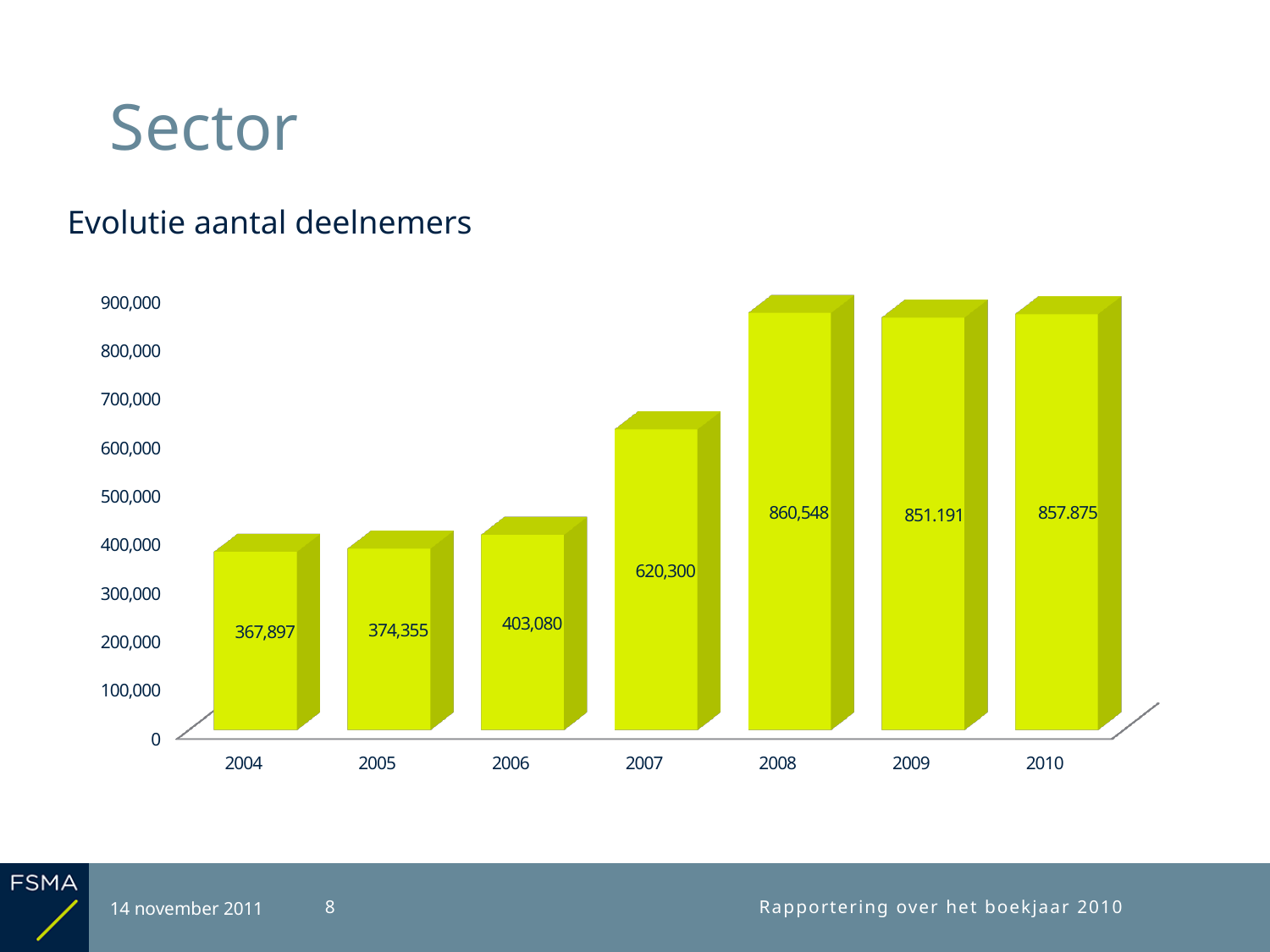
What kind of chart is shown on the slide? bar chart Which year has the lowest value? 2004 Which is larger, the value for 2006 or the value for 2007? 2007 What is the difference between the values for 2007 and 2006? 217,220 Is the value for 2007 greater or less than 600,000? greater What is the value for 2004? 367,897 How many years are shown on the x axis? 7 What is the value for 2007? 620,300 What is the value for 2009? 851.191 What is the difference between the values for 2005 and 2004? 6,458 Which year has the highest value? 2008 What is the value for 2010? 857.875